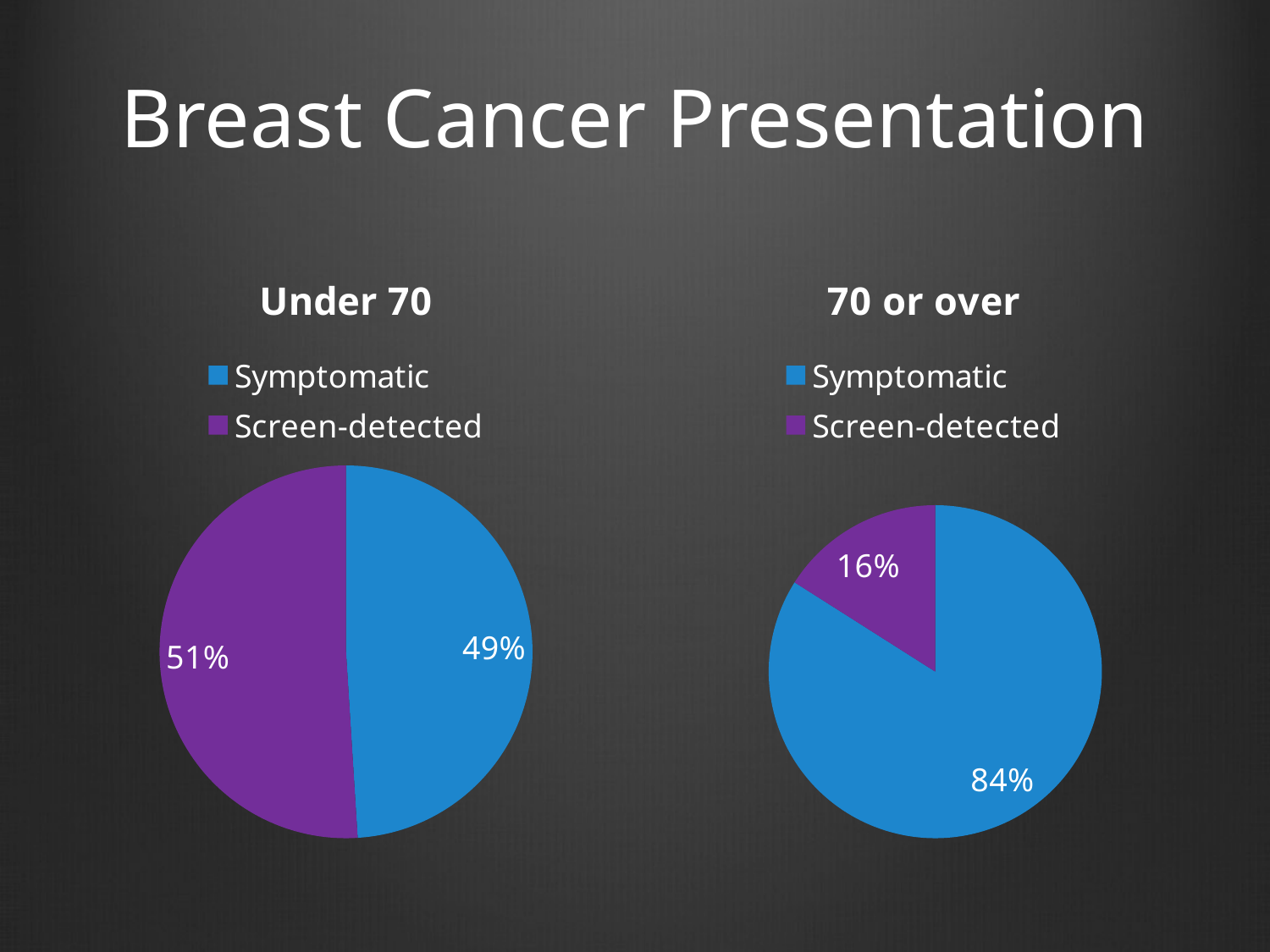
In the "70 or over" chart, what share is Symptomatic? 84% In the "Under 70" chart, what colour is the Screen-detected slice? Purple In the "Under 70" chart, what share is Screen-detected? 51% Is the Symptomatic share larger in the "Under 70" chart or the "70 or over" chart? 70 or over In the "Under 70" chart, what share is Symptomatic? 49% In the "70 or over" chart, what is the difference between the Symptomatic and Screen-detected shares? 68% In the "70 or over" chart, which slice is the smallest? Screen-detected What kind of chart is the "Under 70" chart? Pie chart In the "70 or over" chart, what share is Screen-detected? 16% In the "Under 70" chart, what is the difference between the Screen-detected and Symptomatic shares? 2% In the "70 or over" chart, which slice is the largest? Symptomatic How many slices does the "70 or over" chart have? 2